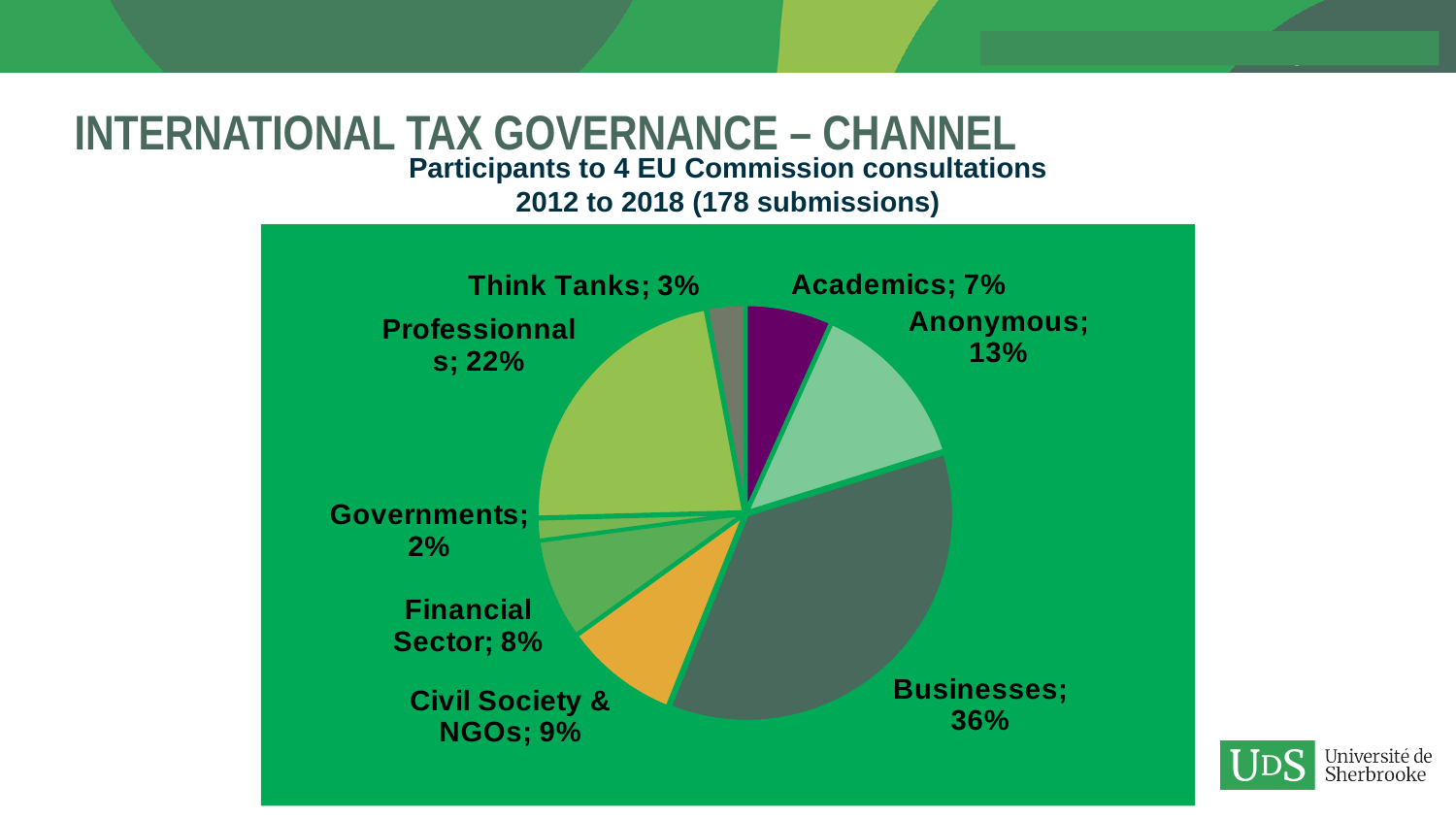
Which has a larger share, Financial Sector or Academics? Financial Sector What share of submissions came from Anonymous participants? 13% What share of submissions came from Businesses? 36% How many participant categories are shown in the pie chart? 8 What is the combined share of Think Tanks and Governments? 5% How many submissions does the chart title say were included? 178 Which participant category has the smallest share of submissions? Governments What kind of chart is shown on the slide? Pie chart What share of submissions came from Civil Society & NGOs? 9% What share of submissions came from Professionnals? 22% What is the difference in percentage points between the Businesses share and the Professionnals share? 14 Which participant category has the largest share of submissions? Businesses